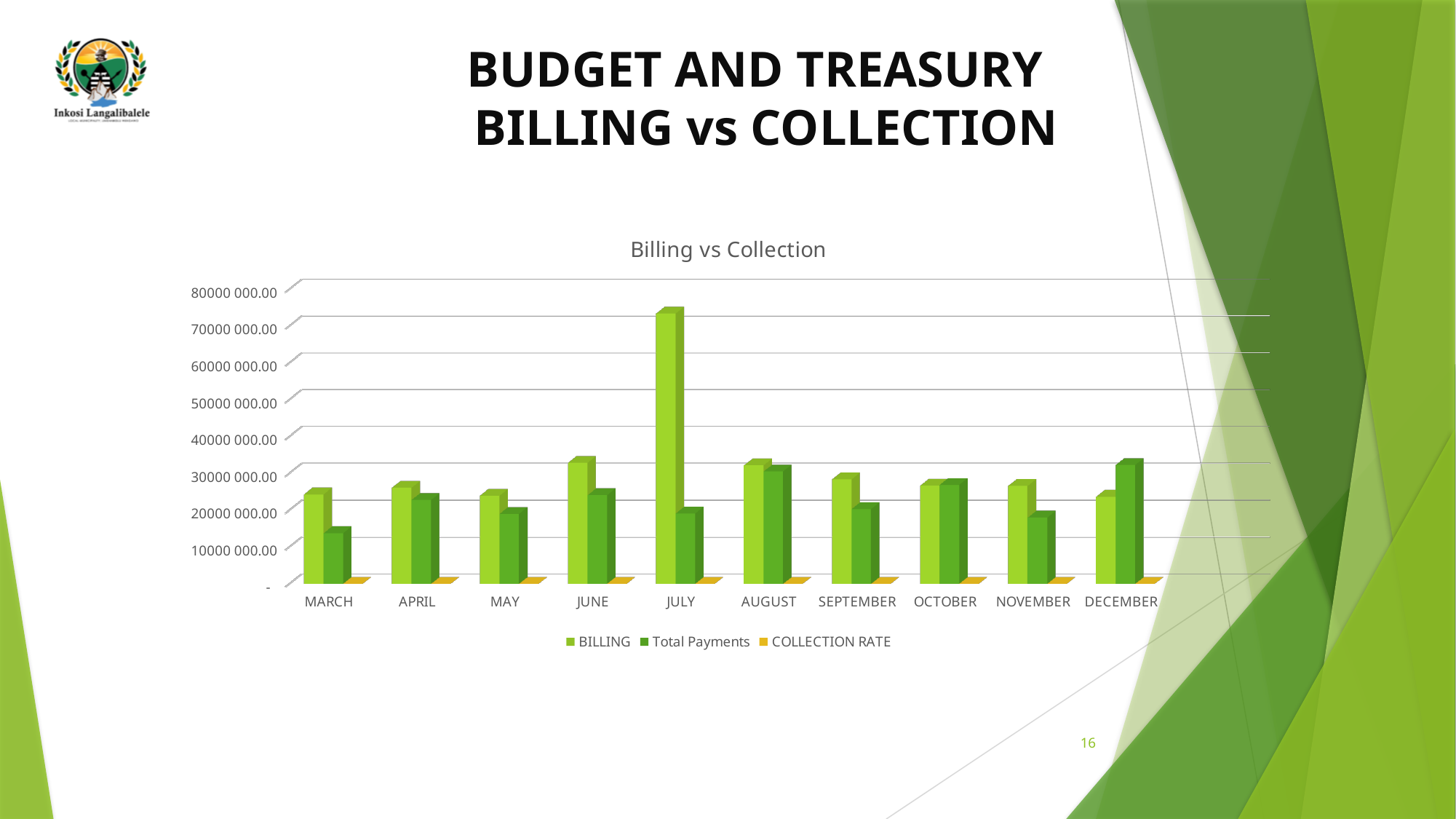
How many months are shown on the x axis of the chart? 10 In DECEMBER, which is larger: BILLING or Total Payments? Total Payments What kind of chart is shown on the slide? Bar chart Is the Total Payments value for MARCH greater or less than 20000 000.00? less In JULY, which is larger: BILLING or Total Payments? BILLING Is the BILLING value for JULY greater or less than 60000 000.00? greater What is the title of the chart? Billing vs Collection Is the BILLING value for MAY greater or less than 30000 000.00? less Which series is shown in orange in the legend? COLLECTION RATE Which month has the highest BILLING value? JULY How many series does the chart legend list? 3 Which month has the lowest Total Payments value? MARCH